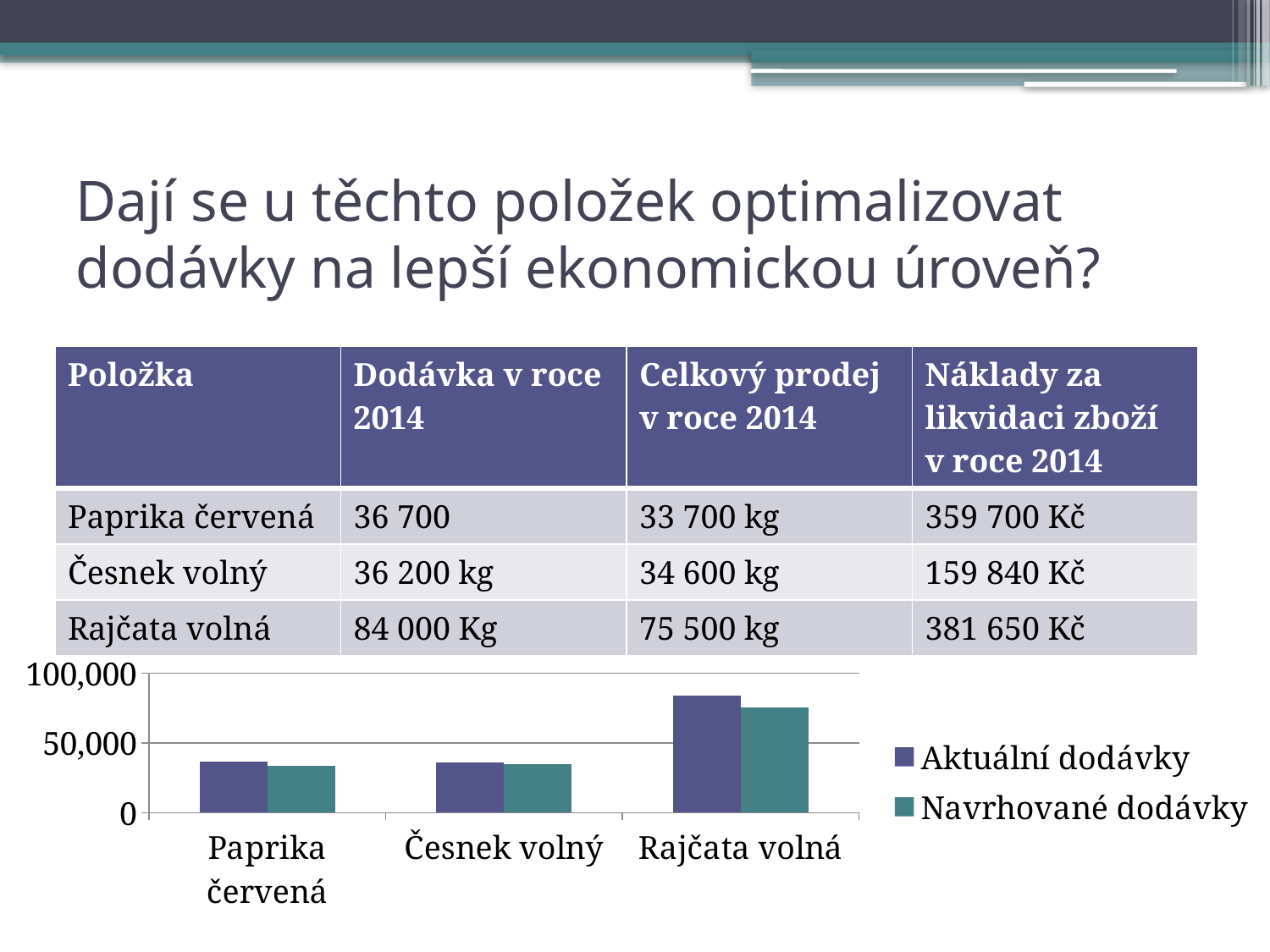
Is the Aktuální dodávky value for Rajčata volná greater or less than 50,000? greater How many series does the chart legend list? 2 Is the Navrhované dodávky value for Česnek volný greater or less than 50,000? less Which category has the highest value for Navrhované dodávky? Rajčata volná What are the two series named in the chart legend? Aktuální dodávky and Navrhované dodávky Which is larger: the Aktuální dodávky value for Rajčata volná or for Česnek volný? Rajčata volná Which category has the highest value for Aktuální dodávky? Rajčata volná Is the Aktuální dodávky value for Paprika červená greater or less than 50,000? less What kind of chart is shown on the slide? bar chart For Rajčata volná, which is larger: Aktuální dodávky or Navrhované dodávky? Aktuální dodávky How many categories are shown on the x axis of the chart? 3